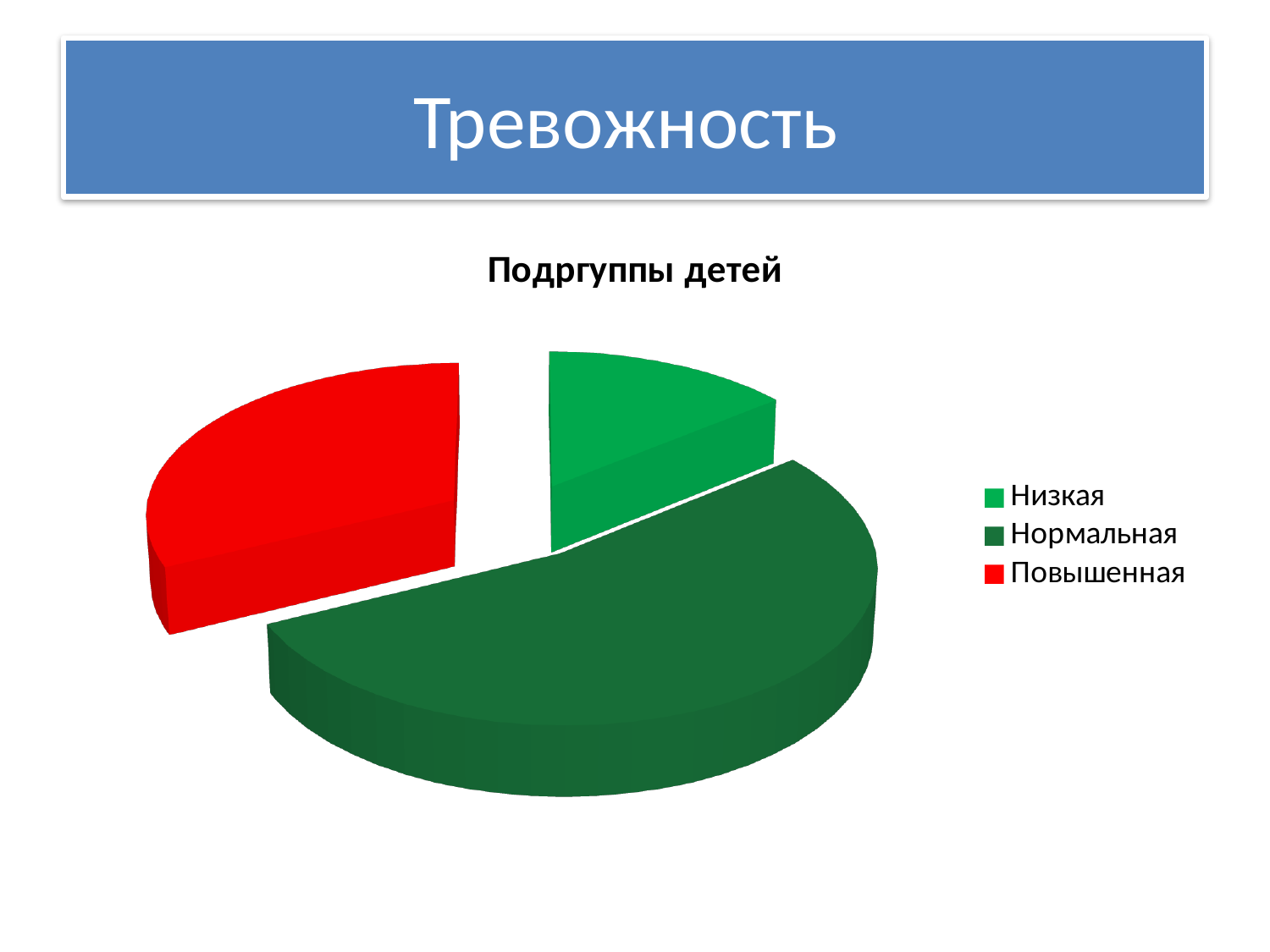
Which slice is larger, Низкая or Нормальная? Нормальная Which category has the smallest slice of the pie? Низкая How many slices does the pie chart have? 3 How many entries does the legend list? 3 Which slice is larger, Нормальная or Повышенная? Нормальная Which category has the largest slice of the pie? Нормальная Does the Нормальная slice take up more or less than half of the pie? more What is the title of the chart? Подргуппы детей What kind of chart is shown on the slide? pie chart Which slice is larger, Повышенная or Низкая? Повышенная What colour is the slice for Повышенная? red